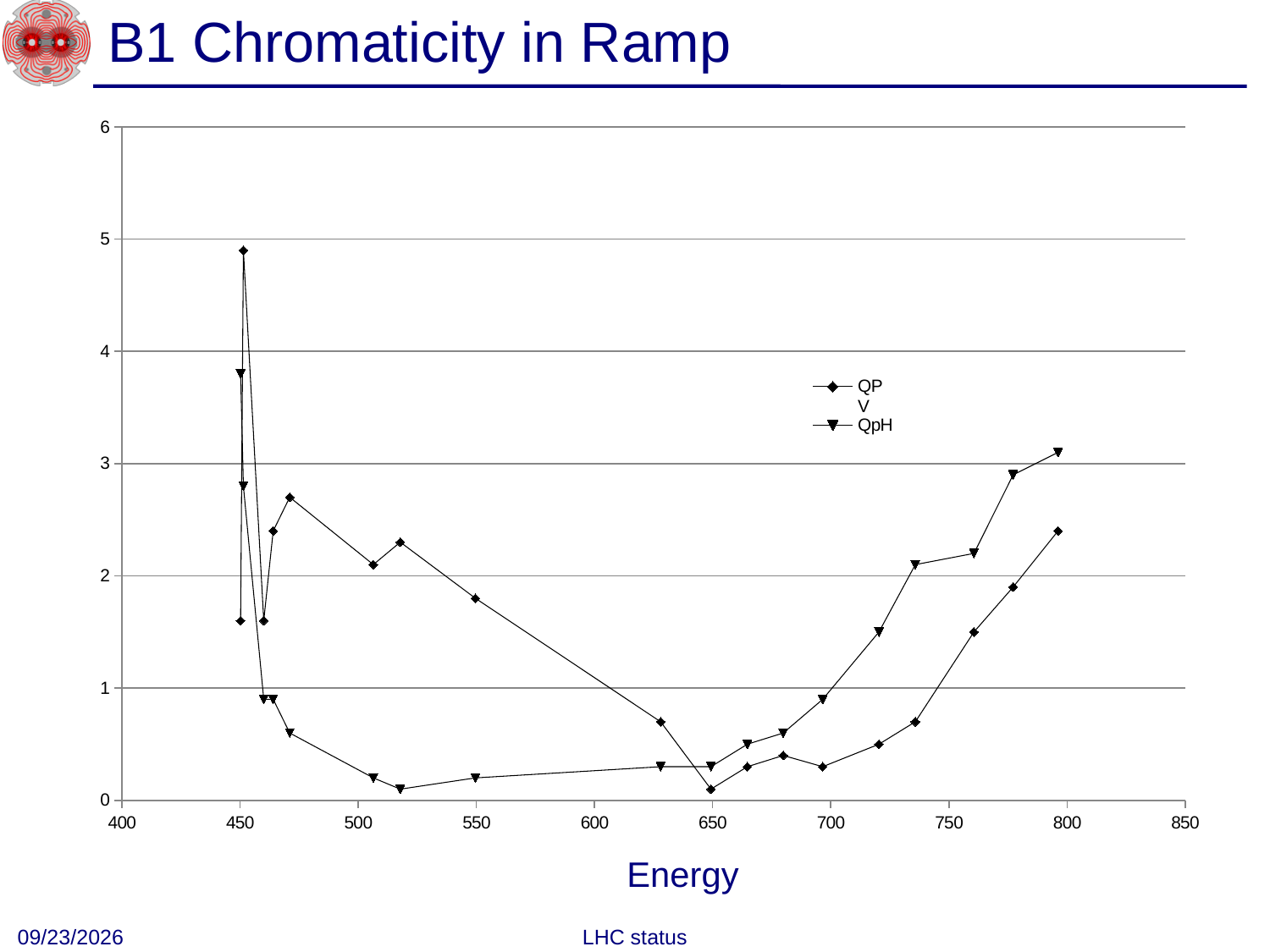
What kind of chart is shown on the slide? line chart Is the QpH value at the right end of the chart (near Energy 800) greater or less than 3? greater At Energy 800, which series has the larger value, QP V or QpH? QpH What is the label of the x axis? Energy What is the title of the chart? B1 Chromaticity in Ramp Between Energy 650 and Energy 800, do the QpH values rise or fall? rise At Energy 550, which series has the larger value, QP V or QpH? QP V Is the QP V value near Energy 650 greater or less than 1? less How many series does the legend list? 2 Which series reaches the highest value anywhere on the chart? QP V Is the peak value of the QP V series near Energy 450 greater or less than 4? greater